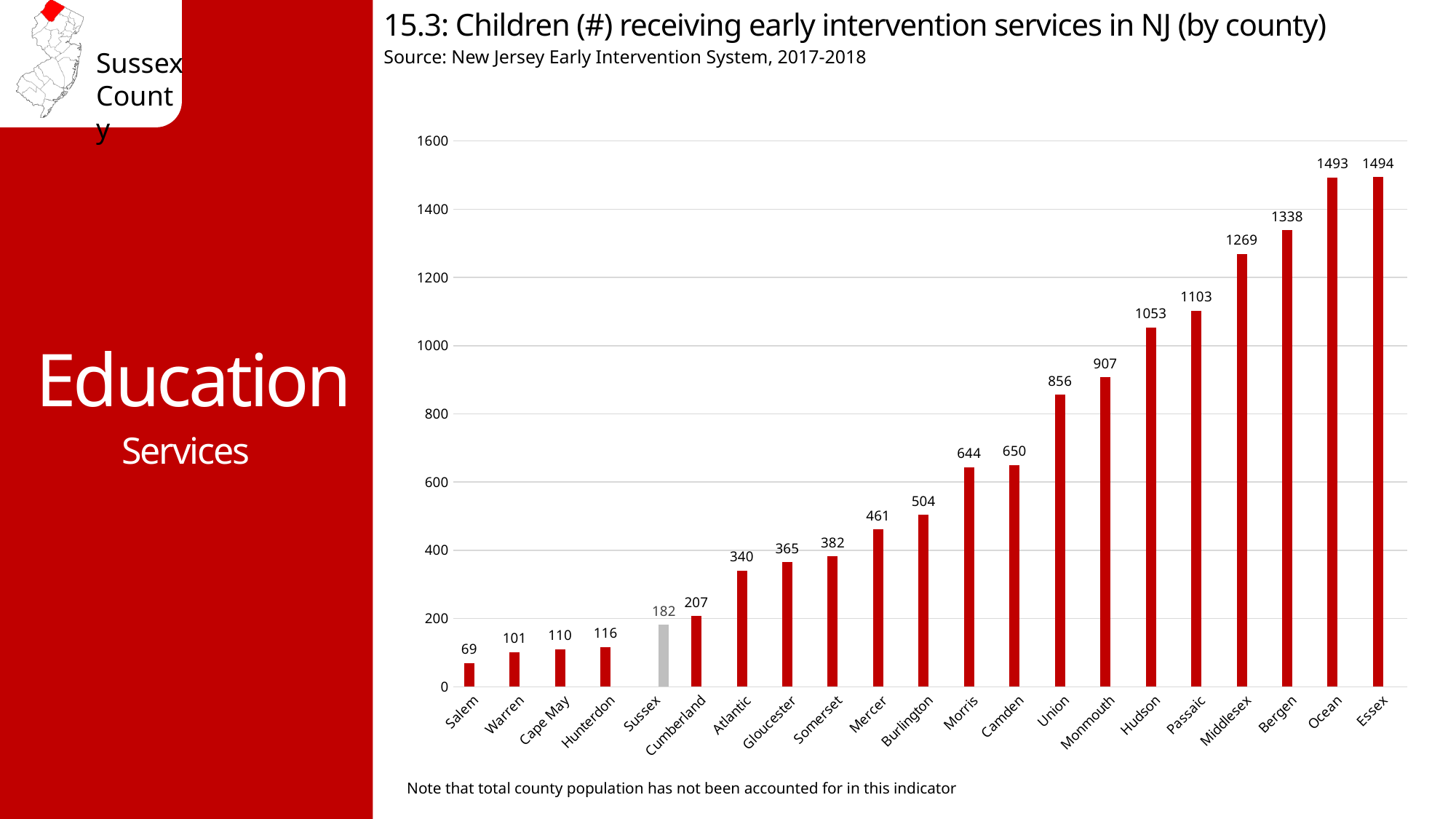
What is the value shown for Mercer County? 461 Which county has the lowest number of children receiving early intervention services? Salem How many counties are shown on the x axis of the chart? 21 Which county has a larger value, Hudson or Union? Hudson What is the value shown for Bergen County? 1338 What is the difference between the values for Cumberland and Sussex counties? 25 What is the difference between the values for Essex and Ocean counties? 1 Do the values generally rise or fall moving from left to right along the x axis? Rise What kind of chart is shown on the slide? Bar chart How many children received early intervention services in Sussex County? 182 Which county has a larger value, Morris or Camden? Camden Which county's bar is coloured grey instead of red? Sussex